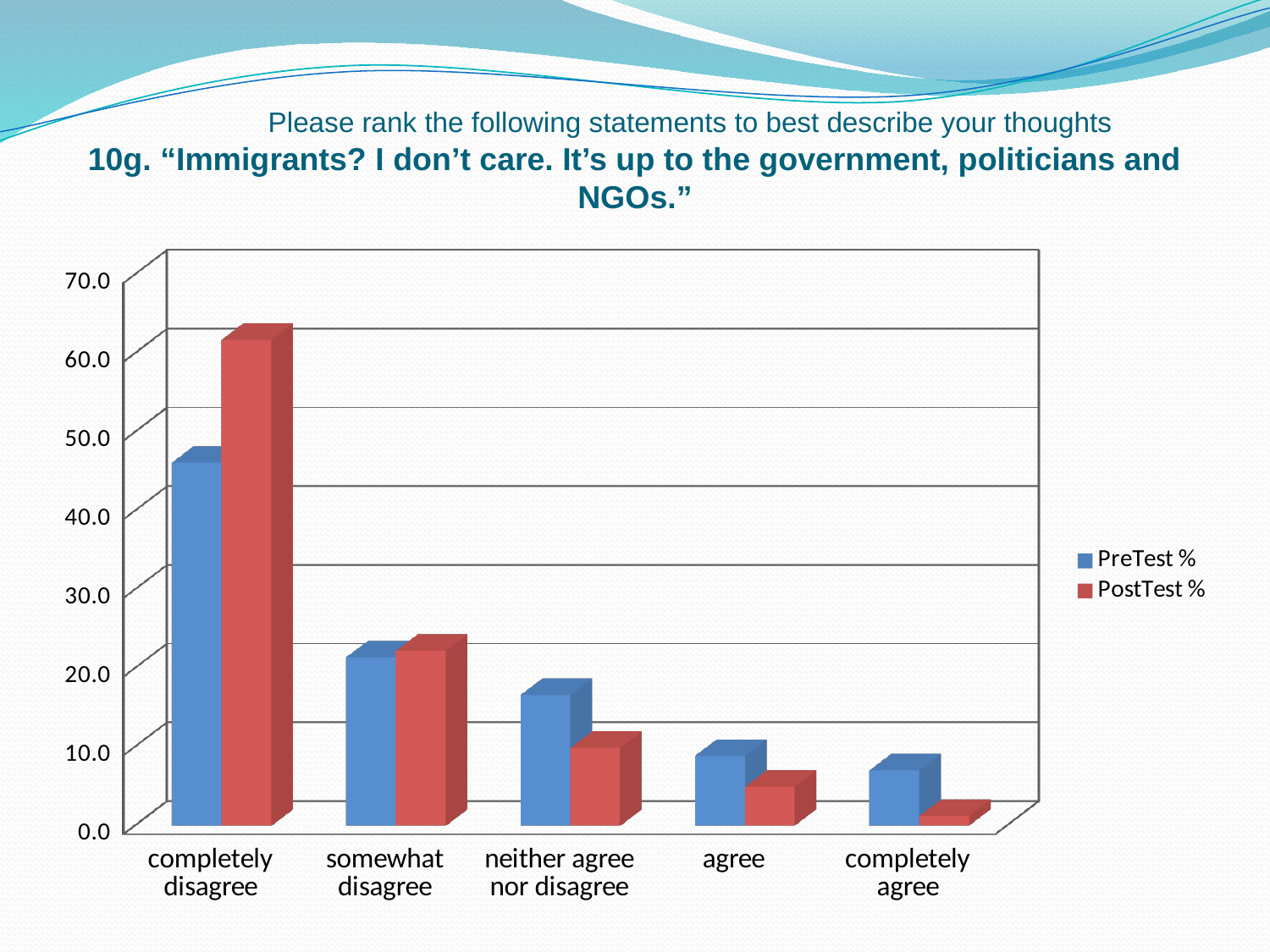
What kind of chart is shown on the slide? bar chart Is the PostTest % value for 'completely disagree' greater or less than 50? greater Which category has the highest PreTest % value? completely disagree Which category has the lowest PostTest % value? completely agree Which category has the highest PostTest % value? completely disagree Is the PostTest % value for 'completely agree' greater or less than 10? less How many series does the legend list? 2 Do the PostTest % values rise or fall moving from 'completely disagree' to 'completely agree'? fall (except a slight rise from 'completely disagree' to 'somewhat disagree' is not present; values fall overall) How many categories are shown on the x axis? 5 For 'neither agree nor disagree', which is larger: PreTest % or PostTest %? PreTest % Is the PreTest % value for 'completely disagree' greater or less than 50? less For 'completely disagree', which is larger: PreTest % or PostTest %? PostTest %